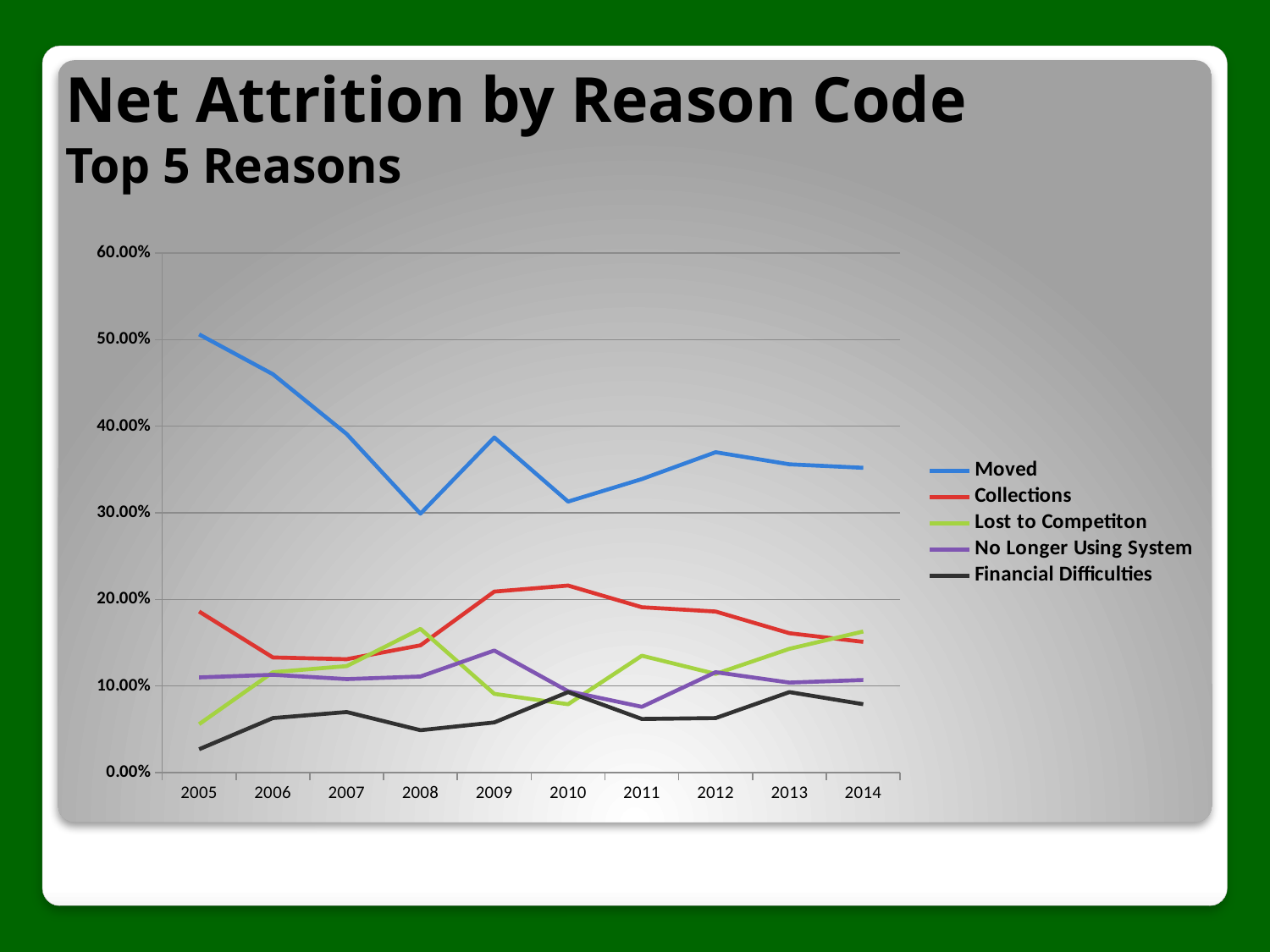
In 2014, which is larger: Moved or Collections? Moved Does the Moved line rise or fall from 2005 to 2008? fall In 2009, which is larger: Collections or Lost to Competiton? Collections What kind of chart is shown on the slide? line chart Which reason code has the lowest value in 2005? Financial Difficulties What is the title of the slide? Net Attrition by Reason Code Is the value for Financial Difficulties in 2005 greater or less than 10.00%? less Is the value for Moved in 2009 greater or less than 30.00%? greater Is the value for Moved in 2006 greater or less than 40.00%? greater Which reason code has the highest value in 2005? Moved How many years are shown along the x axis? 10 How many series does the legend list? 5